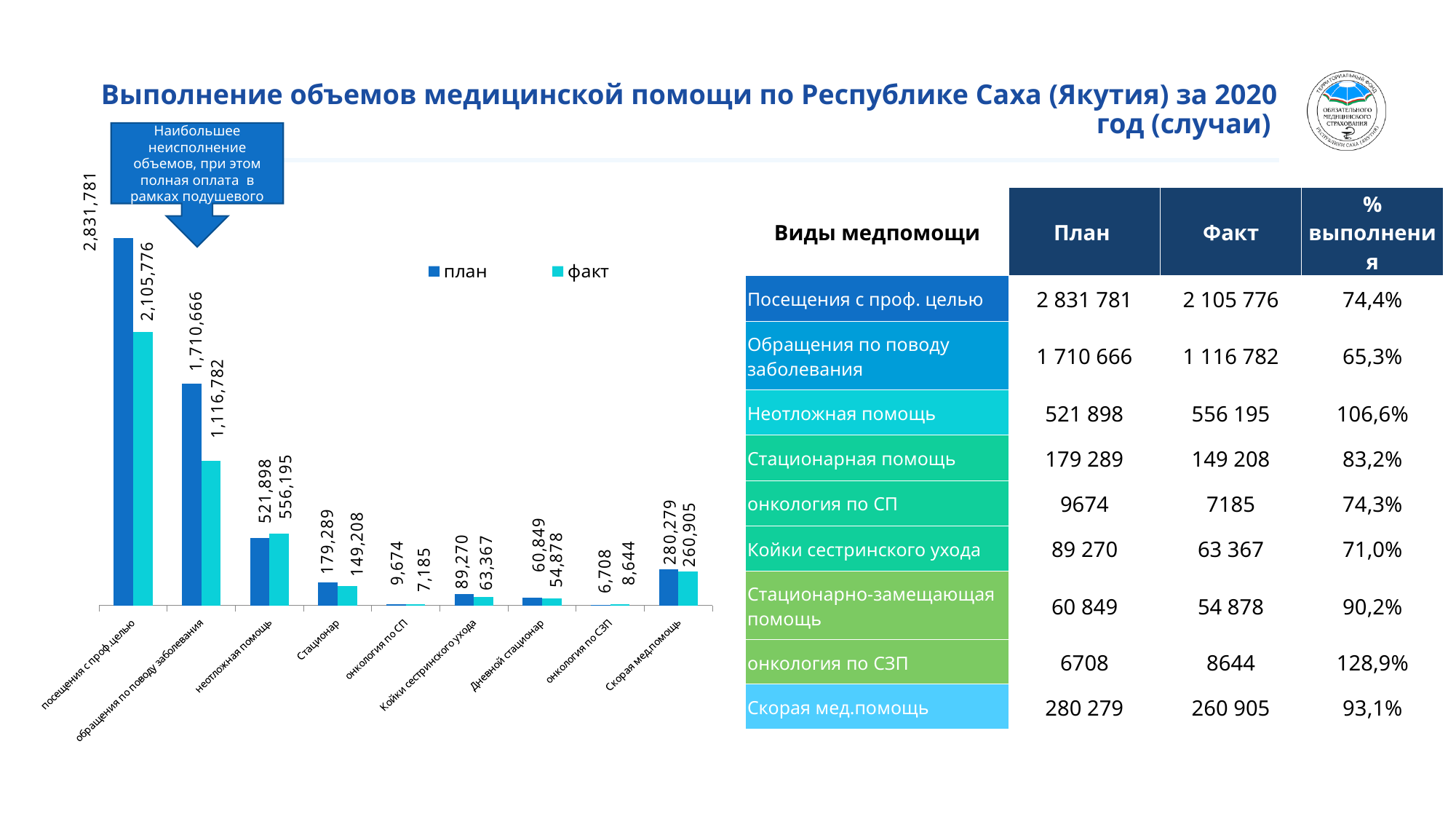
Which category has the lowest план value in the chart? онкология по СЗП What is the факт value for неотложная помощь in the chart? 556,195 How many categories are shown on the x axis of the chart? 9 Which series is shown in dark blue in the chart legend? план How many series does the chart legend list? 2 What is the факт value for Койки сестринского ухода in the chart? 63,367 Which category has the highest план value in the chart? посещения с проф.целью Which is larger for онкология по СЗП: the план value or the факт value? факт What is the difference between the план and факт values for обращения по поводу заболевания? 593,884 What type of chart is shown on the slide? bar chart What is the план value for Скорая мед.помощь in the chart? 280,279 What is the план value for посещения с проф.целью in the chart? 2,831,781